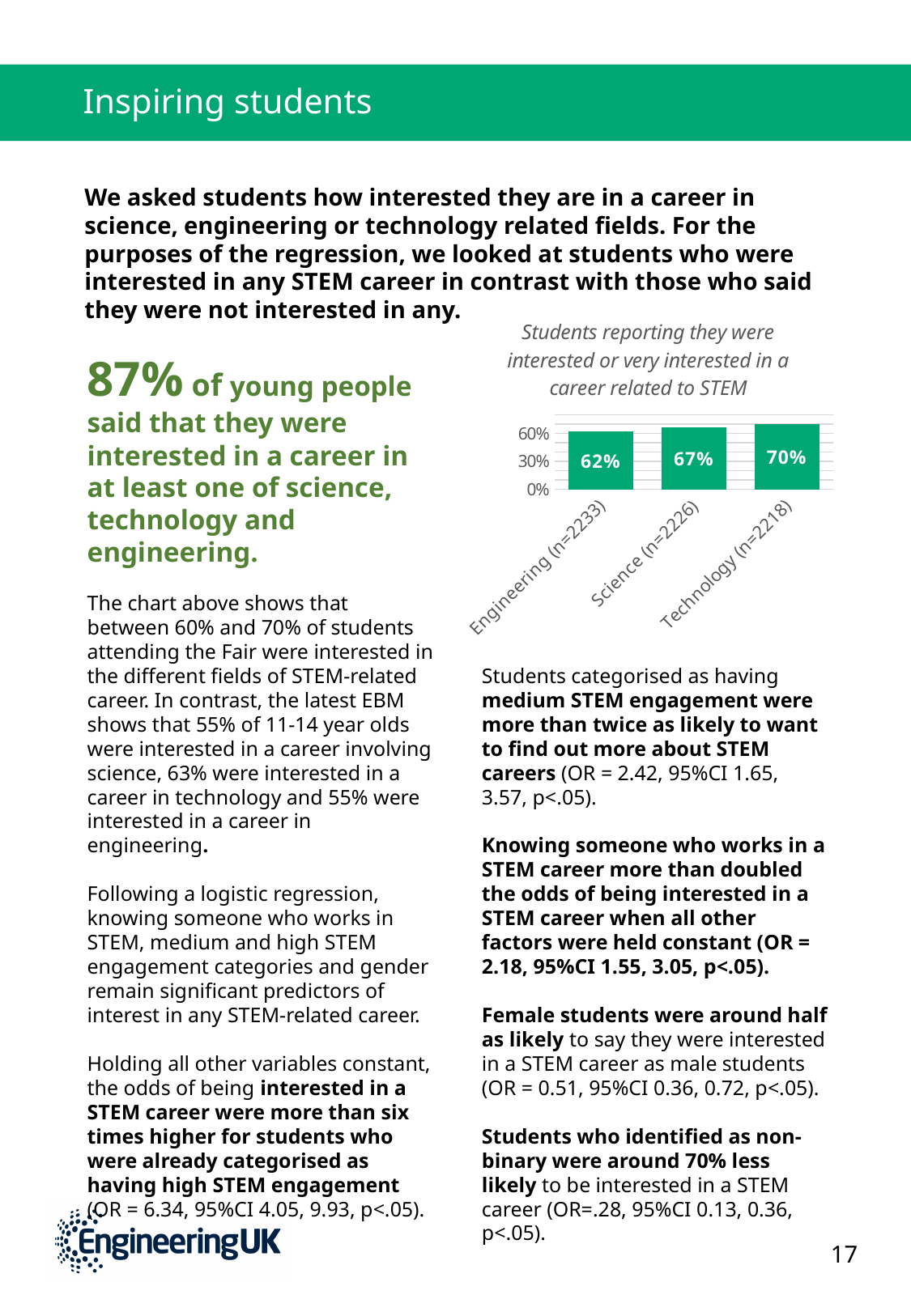
What is the difference in percentage points between Science and Engineering? 5 How many fields are shown in the chart? 3 Which field has the lowest percentage of students interested in a related career? Engineering (n=2233) What is the difference in percentage points between Technology and Engineering? 8 Which has a higher percentage of interested students, Science or Engineering? Science What is the title of the chart? Students reporting they were interested or very interested in a career related to STEM What percentage of students reported being interested or very interested in a career related to Science? 67% Which field has the highest percentage of students interested in a related career? Technology (n=2218) What percentage of students reported being interested or very interested in a career related to Technology? 70% What type of chart is used to show students' interest in STEM careers? Bar chart Is the value for Engineering greater or less than 30%? greater What percentage of students reported being interested or very interested in a career related to Engineering? 62%